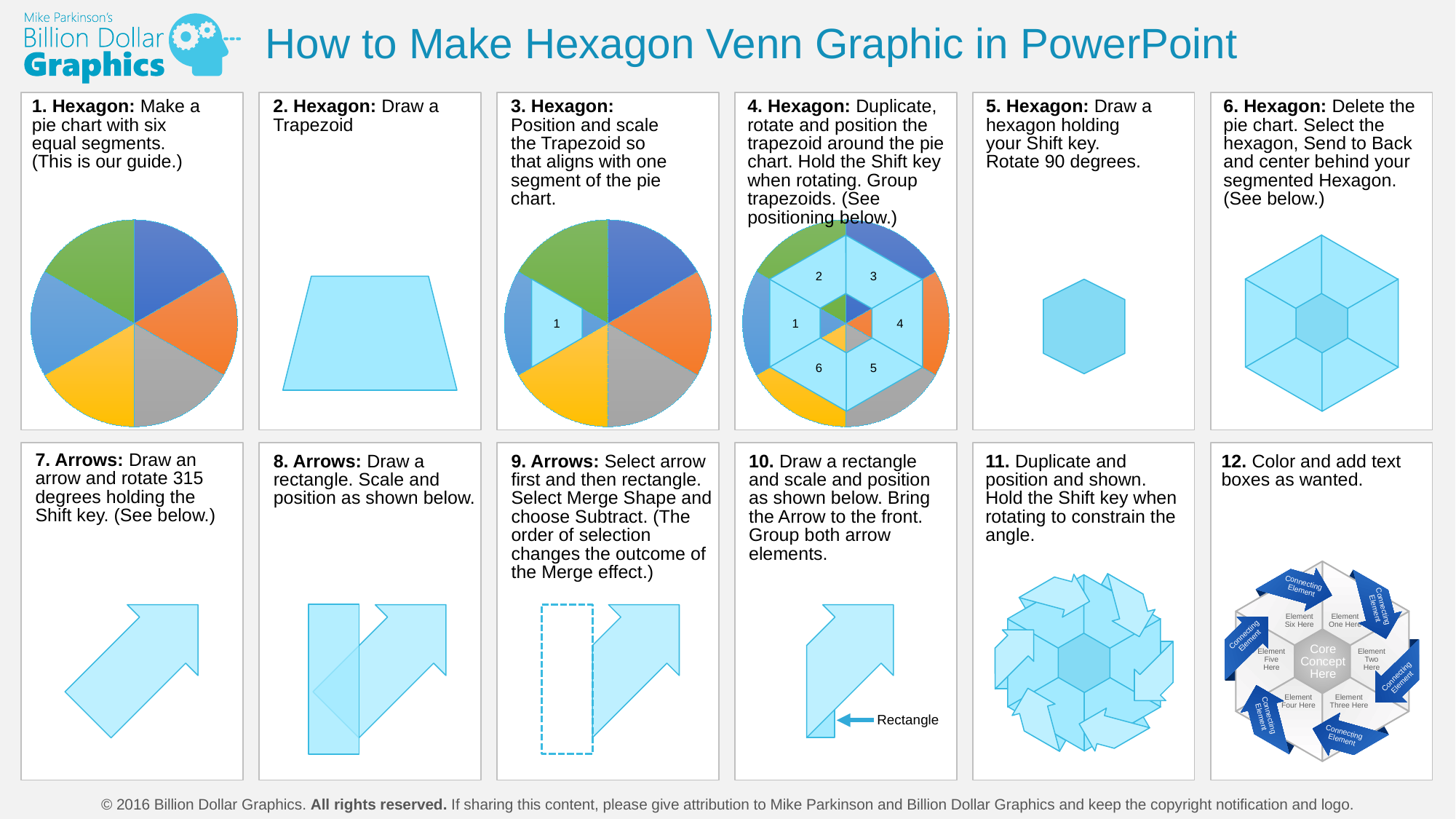
Does the pie chart in step 1 show any data labels or percentages on its segments? no How many segments does the pie chart in step 1 have? 6 In step 4, how many numbered trapezoids are positioned around the pie chart? 6 How many pie charts appear on the slide in total? 3 What kind of chart is shown in step 1 of the slide? pie chart In step 4, what number is printed on the trapezoid at the far left of the pie chart? 1 According to the step 1 text, are the six segments of the pie chart equal or unequal in size? equal In step 4, what number is printed on the trapezoid at the bottom right of the pie chart? 5 What colour is the top-right segment of the pie chart in step 1? blue